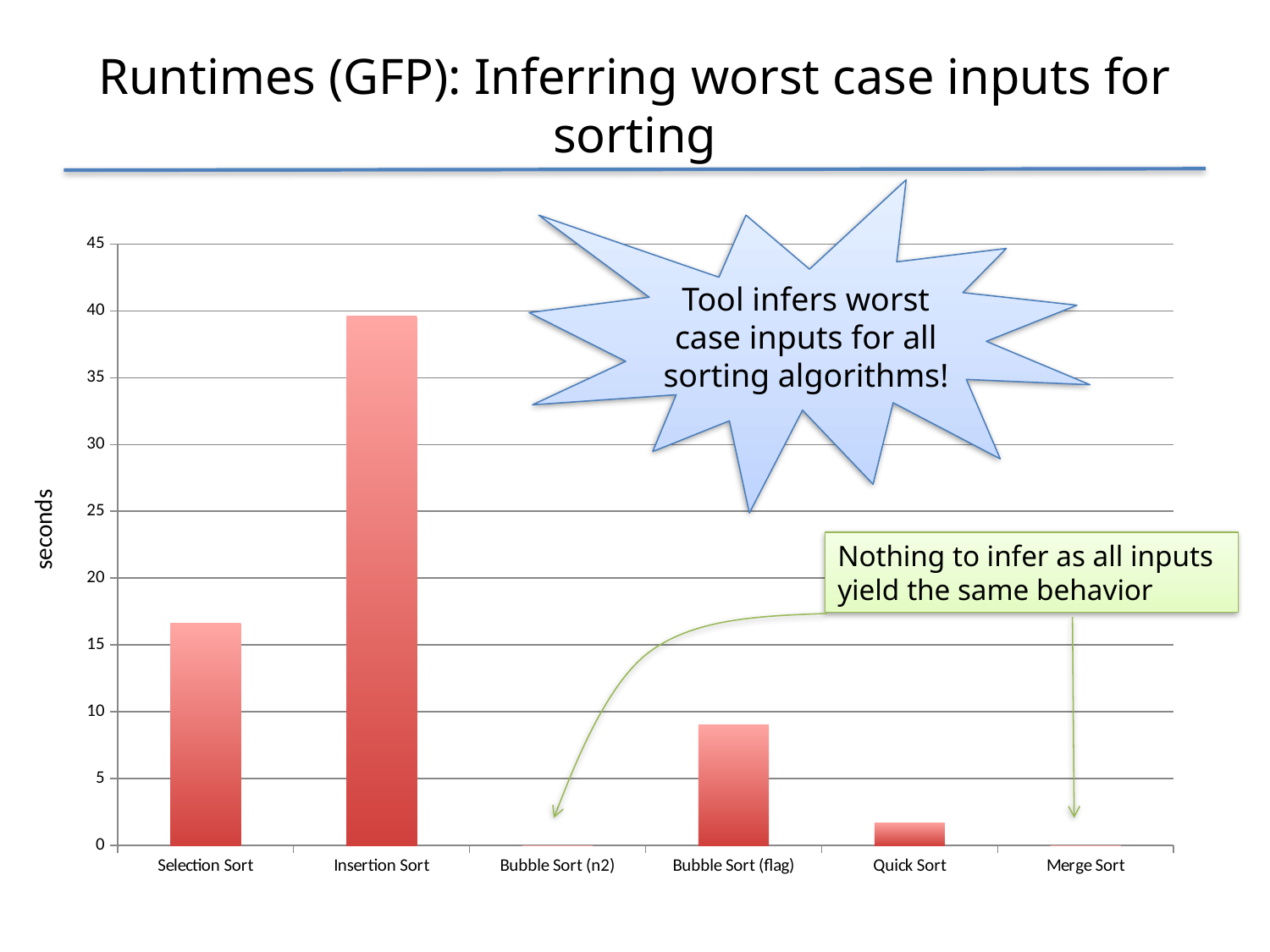
What kind of chart is shown on the slide? bar chart Is the runtime for Bubble Sort (flag) greater or less than 10 seconds? less Is the runtime for Selection Sort greater or less than 15 seconds? greater Which has the larger runtime, Quick Sort or Bubble Sort (flag)? Bubble Sort (flag) Which has the larger runtime, Selection Sort or Bubble Sort (flag)? Selection Sort Is the runtime for Quick Sort greater or less than 5 seconds? less Which has the larger runtime, Insertion Sort or Selection Sort? Insertion Sort Which two sorting algorithms have no bar shown in the chart? Bubble Sort (n2) and Merge Sort Which sorting algorithm has the highest runtime in the chart? Insertion Sort What is the label on the y axis of the chart? seconds How many sorting algorithms are listed along the x axis of the chart? 6